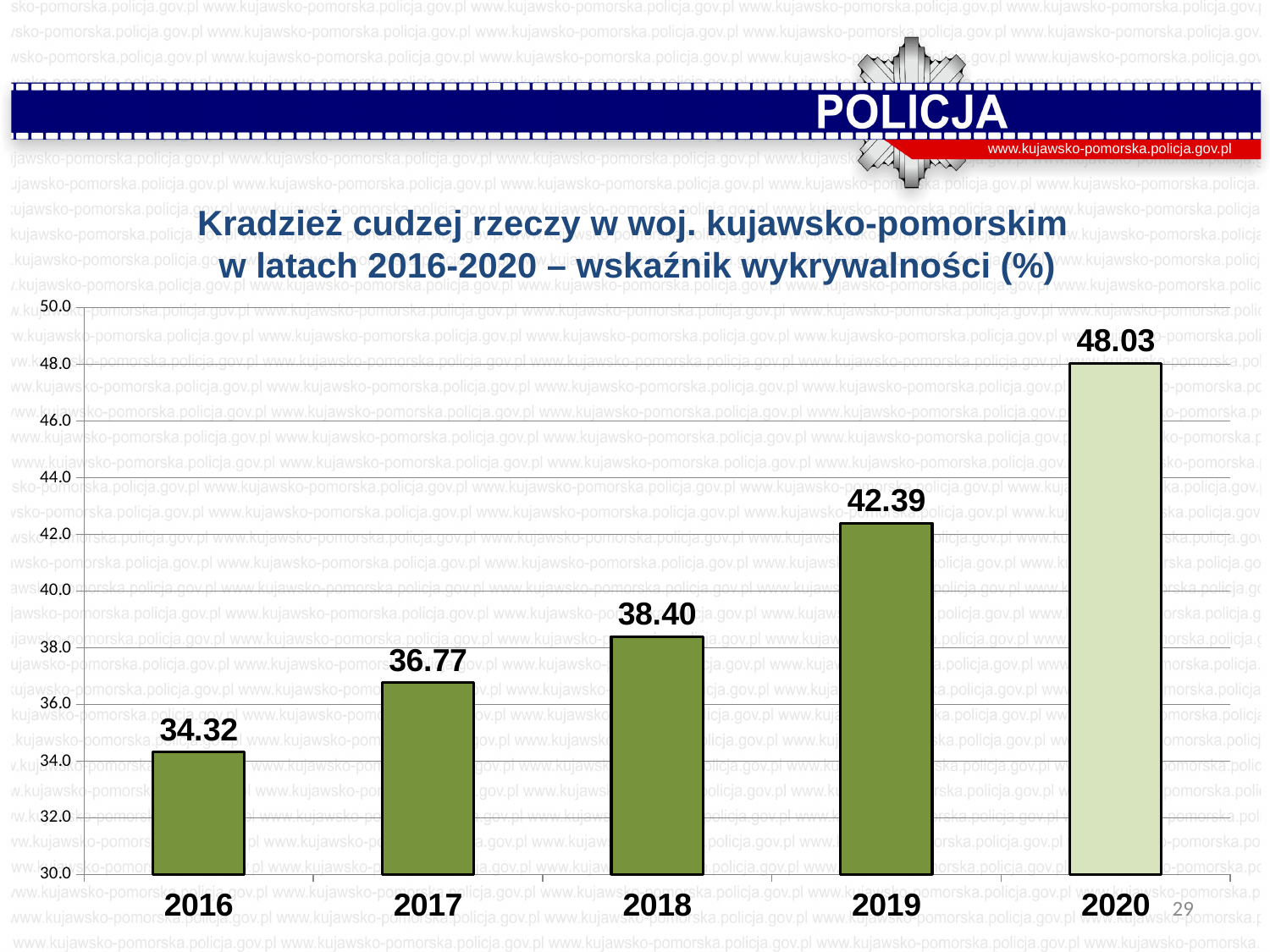
What is the value shown for 2019? 42.39 What is the difference between the values for 2020 and 2019? 5.64 What is the difference between the values for 2017 and 2016? 2.45 What kind of chart is shown on the slide? bar chart Do the values rise or fall from 2016 to 2020? rise How many years are shown on the chart? 5 What is the value shown for 2020? 48.03 Which year has the highest value? 2020 Is the value for 2018 greater or less than 40.0? less What is the detection rate value for 2016? 34.32 Which year has the lowest value? 2016 Which is larger, the value for 2018 or the value for 2017? 2018